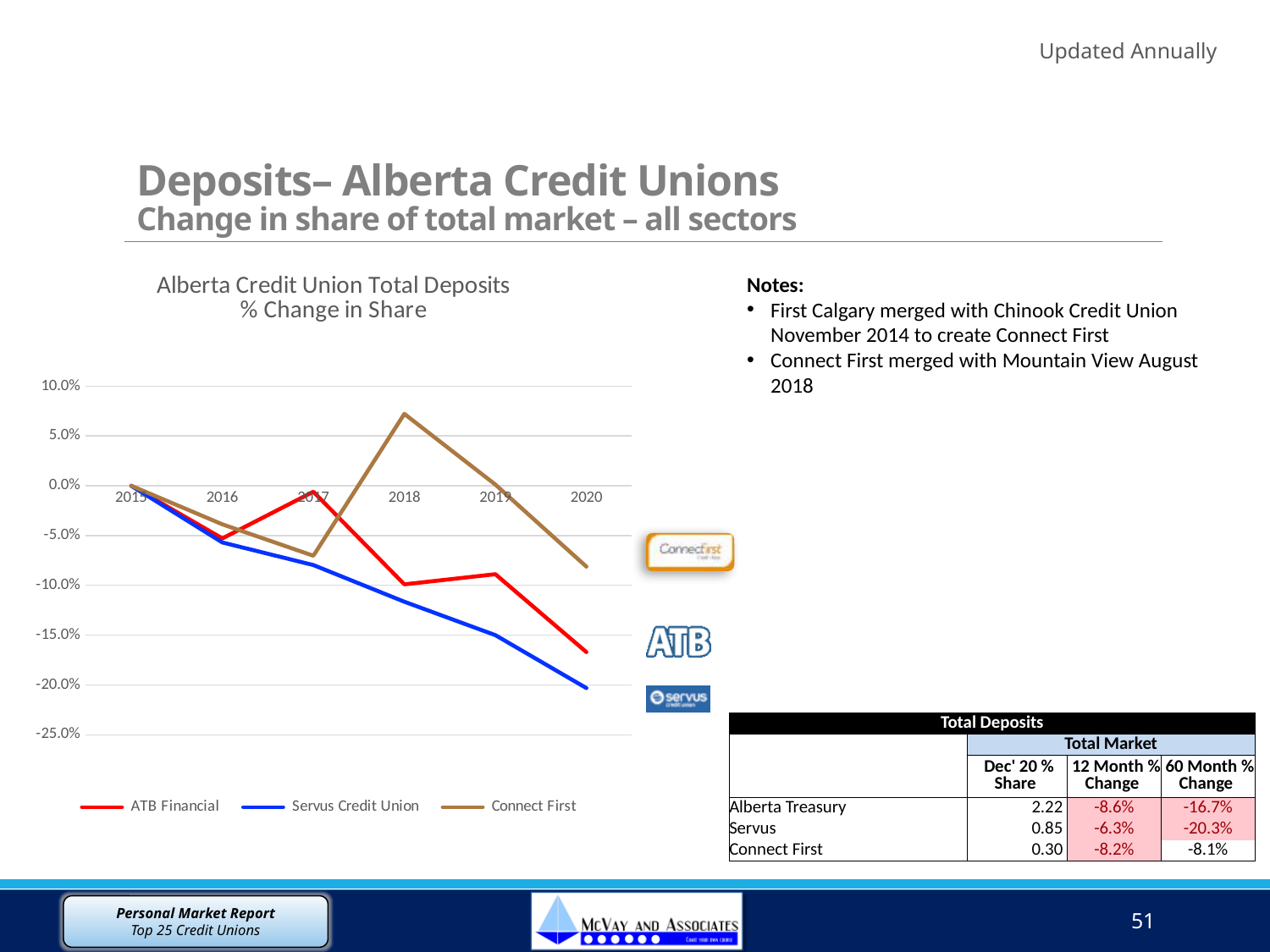
What type of chart is shown on the slide? line chart How many series does the chart legend list? 3 In 2019, which is higher: Connect First or ATB Financial? Connect First Is the value for Connect First in 2020 greater or less than -10.0%? greater What colour is the Servus Credit Union line in the chart? blue Which series has the highest value in 2018? Connect First Is the value for ATB Financial in 2020 greater or less than -10.0%? less Does the Servus Credit Union line rise or fall from 2015 to 2020? fall Which series has the lowest value in 2020? Servus Credit Union Is the value for Connect First in 2018 greater or less than 5.0%? greater How many years are plotted along the x axis of the chart? 6